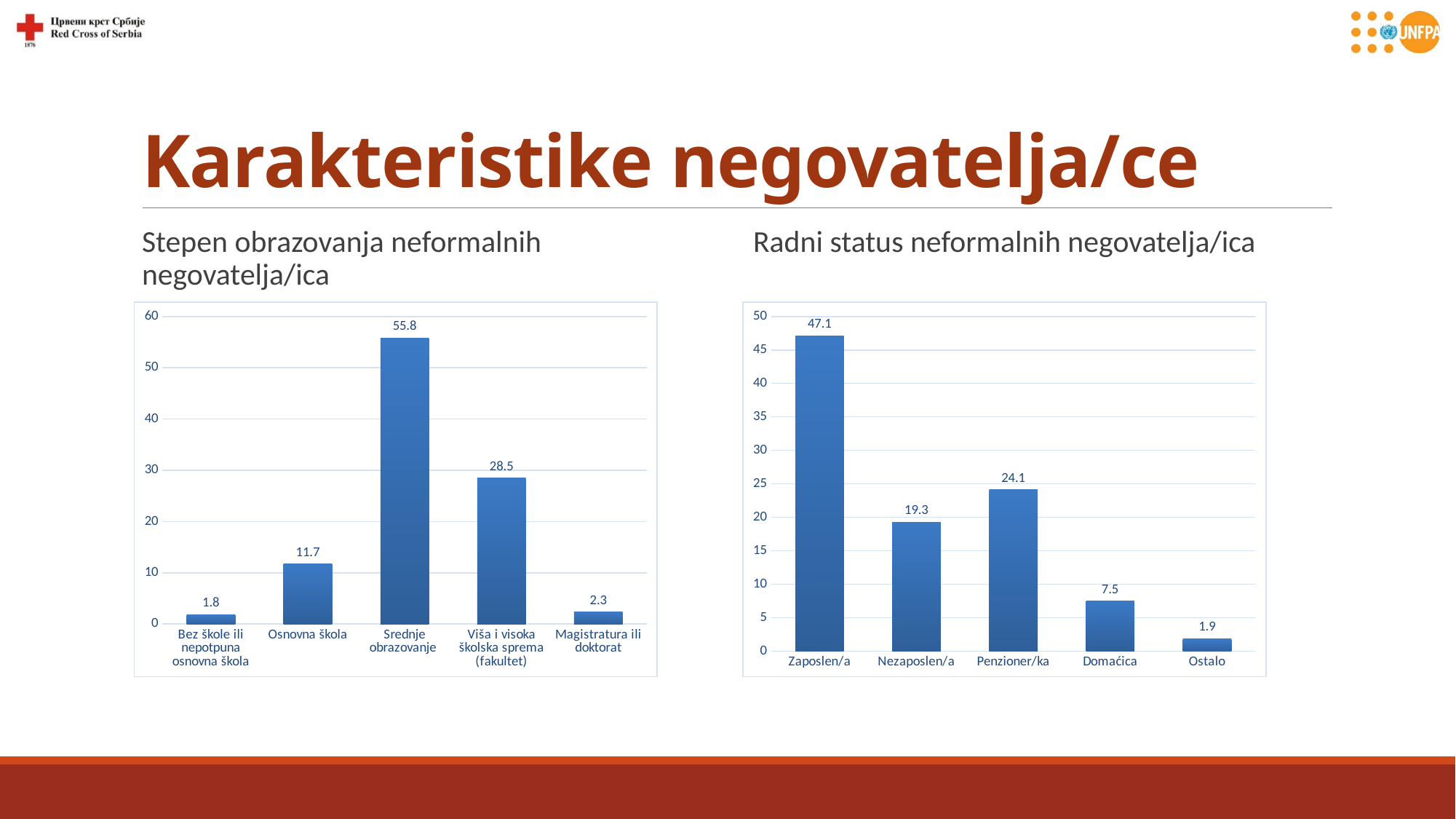
What type of chart is the right chart (Radni status neformalnih negovatelja/ica)? Bar chart In the left chart (Stepen obrazovanja neformalnih negovatelja/ica), which category has the lowest value? Bez škole ili nepotpuna osnovna škola In the left chart (Stepen obrazovanja neformalnih negovatelja/ica), how many categories are shown? 5 In the right chart (Radni status neformalnih negovatelja/ica), is the value for Nezaposlen/a greater or less than 20? less In the right chart (Radni status neformalnih negovatelja/ica), what is the difference between Penzioner/ka and Nezaposlen/a? 4.8 In the right chart (Radni status neformalnih negovatelja/ica), what is the value for Zaposlen/a? 47.1 In the left chart (Stepen obrazovanja neformalnih negovatelja/ica), what is the difference between Srednje obrazovanje and Viša i visoka školska sprema (fakultet)? 27.3 In the left chart (Stepen obrazovanja neformalnih negovatelja/ica), what is the value for Osnovna škola? 11.7 In the left chart (Stepen obrazovanja neformalnih negovatelja/ica), what is the value for Srednje obrazovanje? 55.8 In the left chart (Stepen obrazovanja neformalnih negovatelja/ica), which is larger: Magistratura ili doktorat or Bez škole ili nepotpuna osnovna škola? Magistratura ili doktorat In the right chart (Radni status neformalnih negovatelja/ica), what is the value for Domaćica? 7.5 In the right chart (Radni status neformalnih negovatelja/ica), which category has the highest value? Zaposlen/a